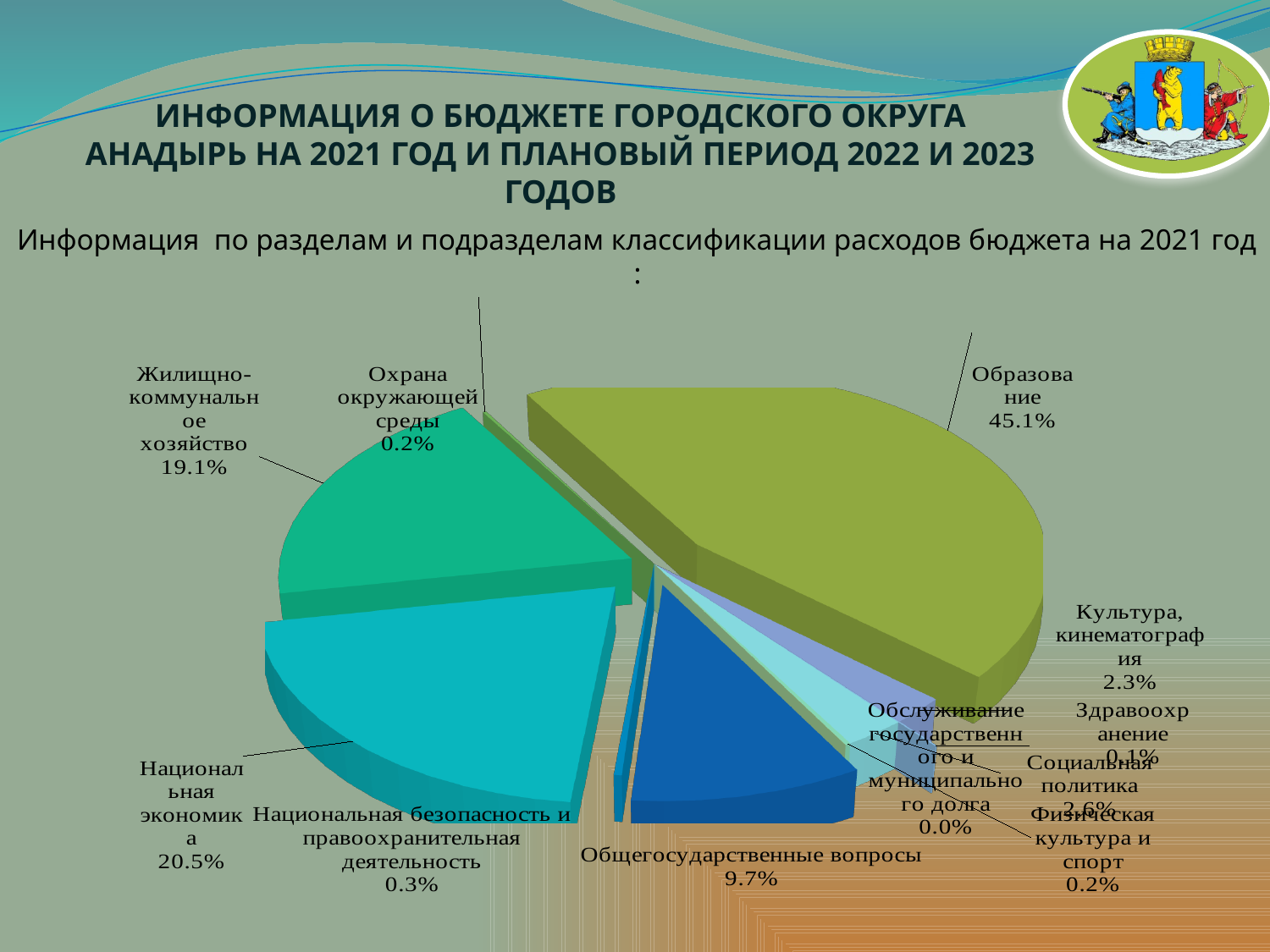
What is the difference in percentage points between Образование and Национальная экономика? 24.6 How many categories are shown in the pie chart? 11 Which is larger: the share for Национальная экономика or for Жилищно-коммунальное хозяйство? Национальная экономика What share is shown for Жилищно-коммунальное хозяйство? 19.1% What type of chart is shown on the slide? Pie chart Which category has the smallest share of the pie? Обслуживание государственного и муниципального долга What share is shown for Общегосударственные вопросы? 9.7% What share is shown for Культура, кинематография? 2.3% Which category has the largest share of the pie? Образование What share of the 2021 budget expenditure goes to Образование? 45.1% What share is shown for Национальная экономика? 20.5% What share is shown for Социальная политика? 2.6%